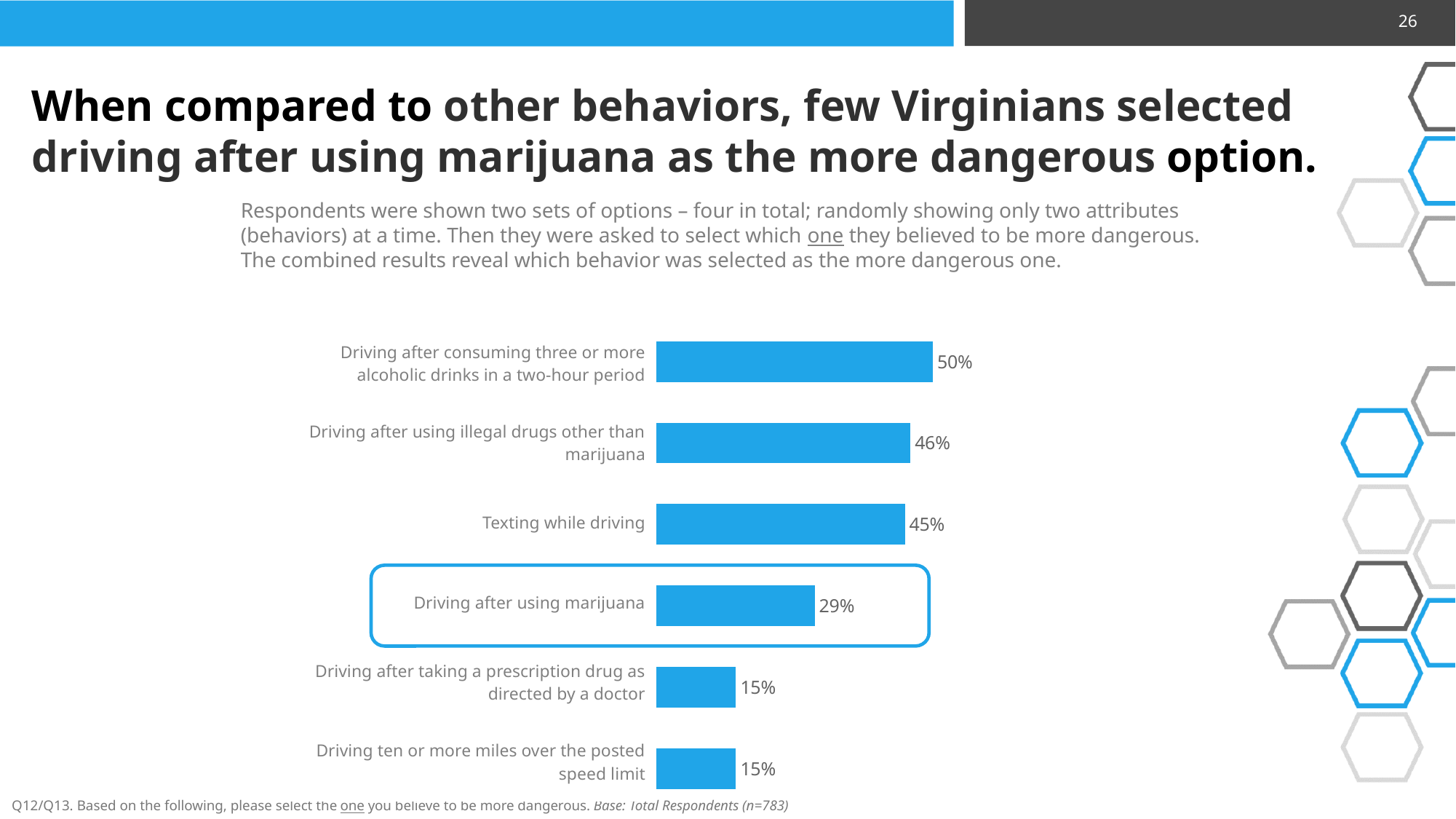
Which is larger: the value for texting while driving or the value for driving after using marijuana? Texting while driving What kind of chart is shown on the slide? Bar chart What is the base (number of respondents) noted at the bottom of the slide? n=783 How many behaviors (categories) are shown in the chart? 6 What percentage of respondents selected driving after using marijuana as the more dangerous option? 29% What is the value shown for texting while driving? 45% What percentage is shown for driving after using illegal drugs other than marijuana? 46% What value is shown for driving ten or more miles over the posted speed limit? 15% Which behavior is highlighted with a rounded outline box in the chart? Driving after using marijuana What is the difference between the value for texting while driving and the value for driving after taking a prescription drug as directed by a doctor? 30% What is the difference between the value for driving after consuming three or more alcoholic drinks in a two-hour period and the value for driving after using marijuana? 21% Which behavior has the highest percentage in the chart? Driving after consuming three or more alcoholic drinks in a two-hour period